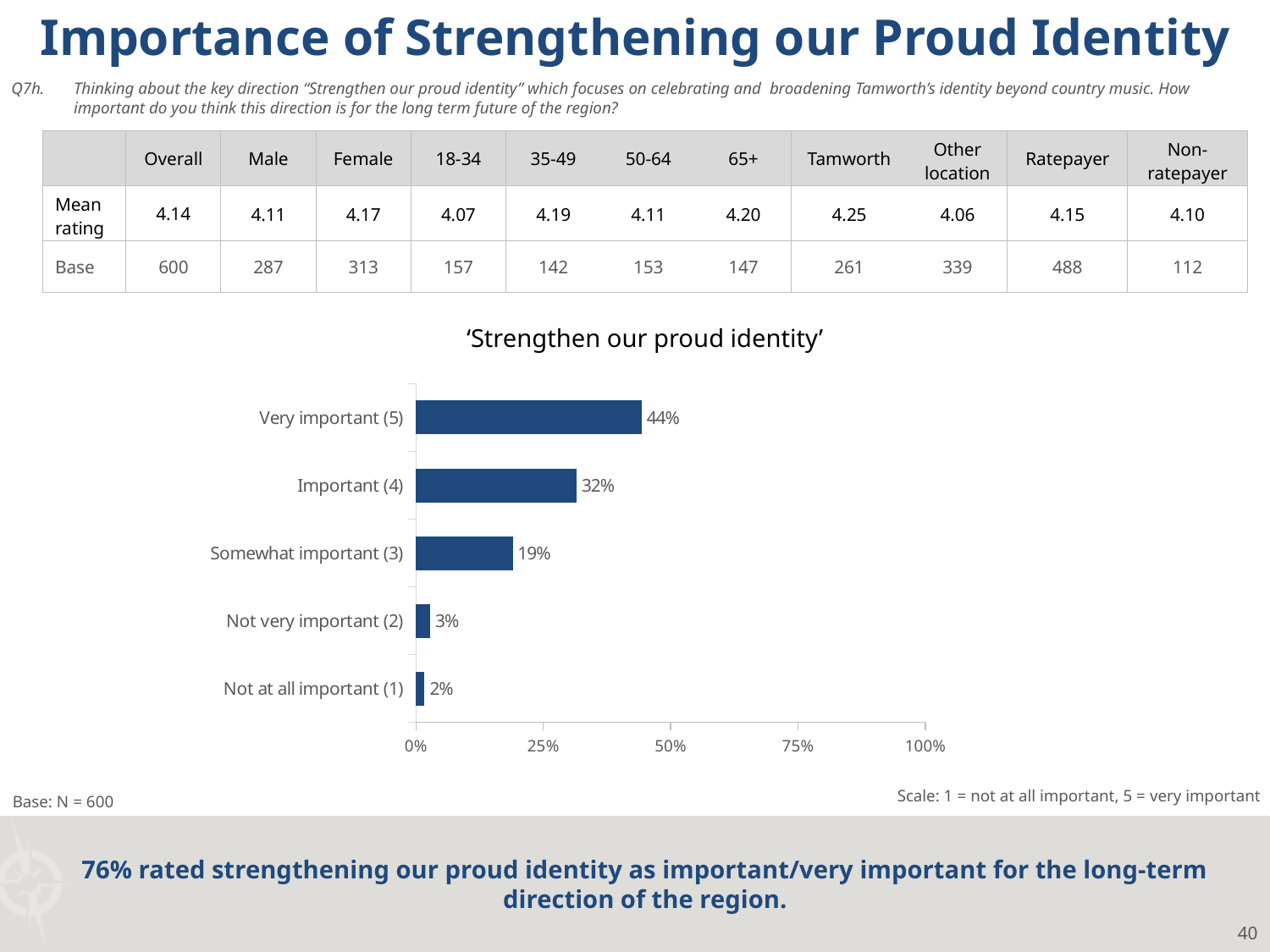
What is the difference in percentage points between Very important (5) and Important (4)? 12 Which rating category has the highest percentage? Very important (5) Which rating category has the lowest percentage? Not at all important (1) Is the value for Very important (5) greater or less than 50%? less What is the title of the chart? 'Strengthen our proud identity' What percentage of respondents chose Important (4)? 32% What type of chart is used to show the importance ratings? Bar chart What percentage of respondents chose Somewhat important (3)? 19% Which is larger: the percentage for Somewhat important (3) or Not very important (2)? Somewhat important (3) What percentage of respondents chose Not very important (2)? 3% How many rating categories are shown in the chart? 5 What percentage of respondents rated 'Strengthen our proud identity' as Very important (5)? 44%